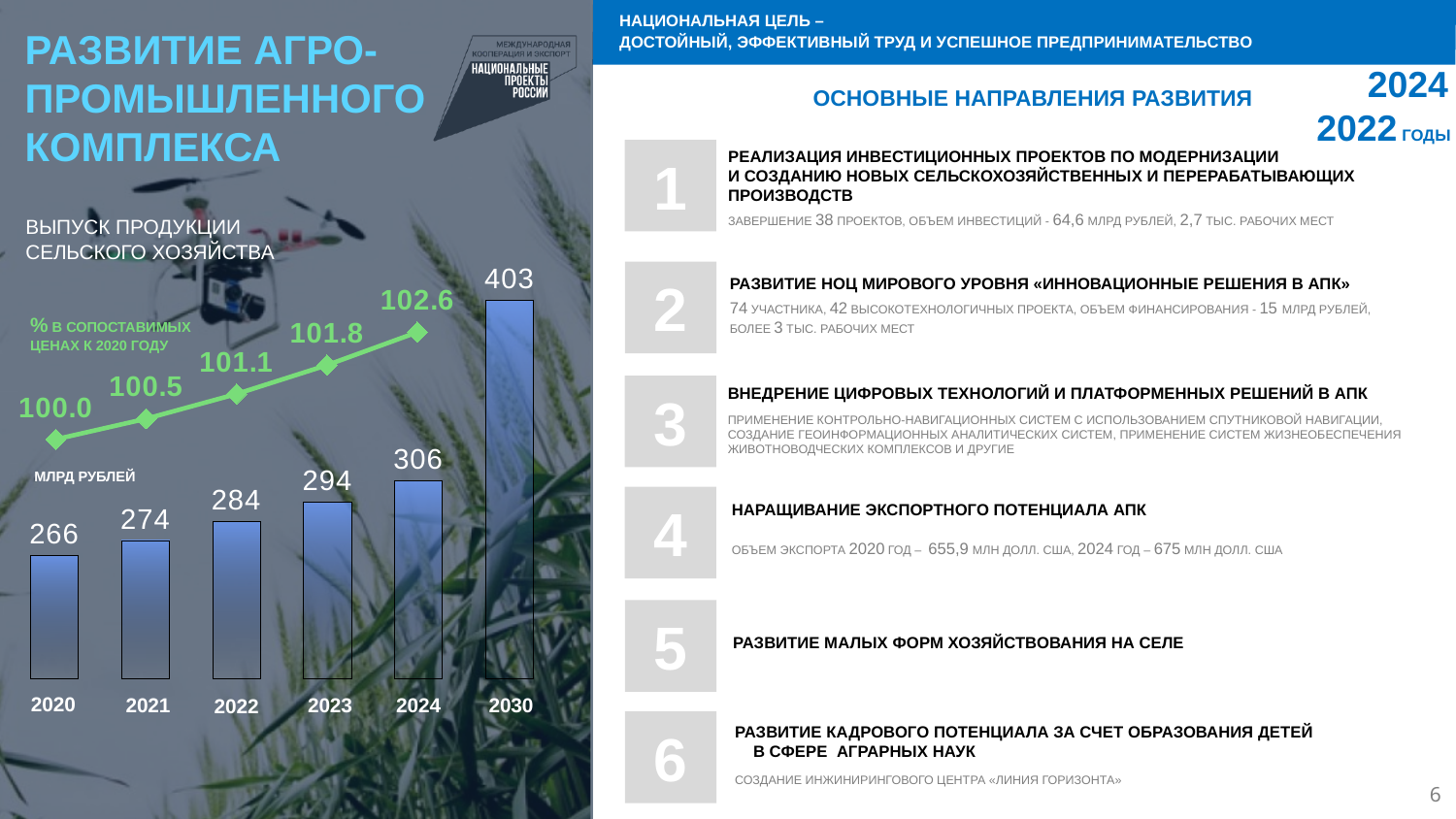
Which year has the highest bar value in the chart? 2030 How many years are shown on the x axis of the chart? 6 Which is larger, the bar value for 2023 or for 2022? 2023 What is the line value (% в сопоставимых ценах к 2020 году) for 2024? 102.6 What is the value of the bar for 2024 in the chart? 306 What is the line value (% в сопоставимых ценах к 2020 году) for 2023? 101.8 Which year has the lowest bar value in the chart? 2020 Do the bar values rise or fall from 2020 to 2030? rise What is the value of the bar for 2020 in the chart 'Выпуск продукции сельского хозяйства'? 266 What is the difference between the bar values for 2022 and 2021? 10 What is the difference between the bar values for 2030 and 2024? 97 What is the value of the bar for 2030 in the chart? 403